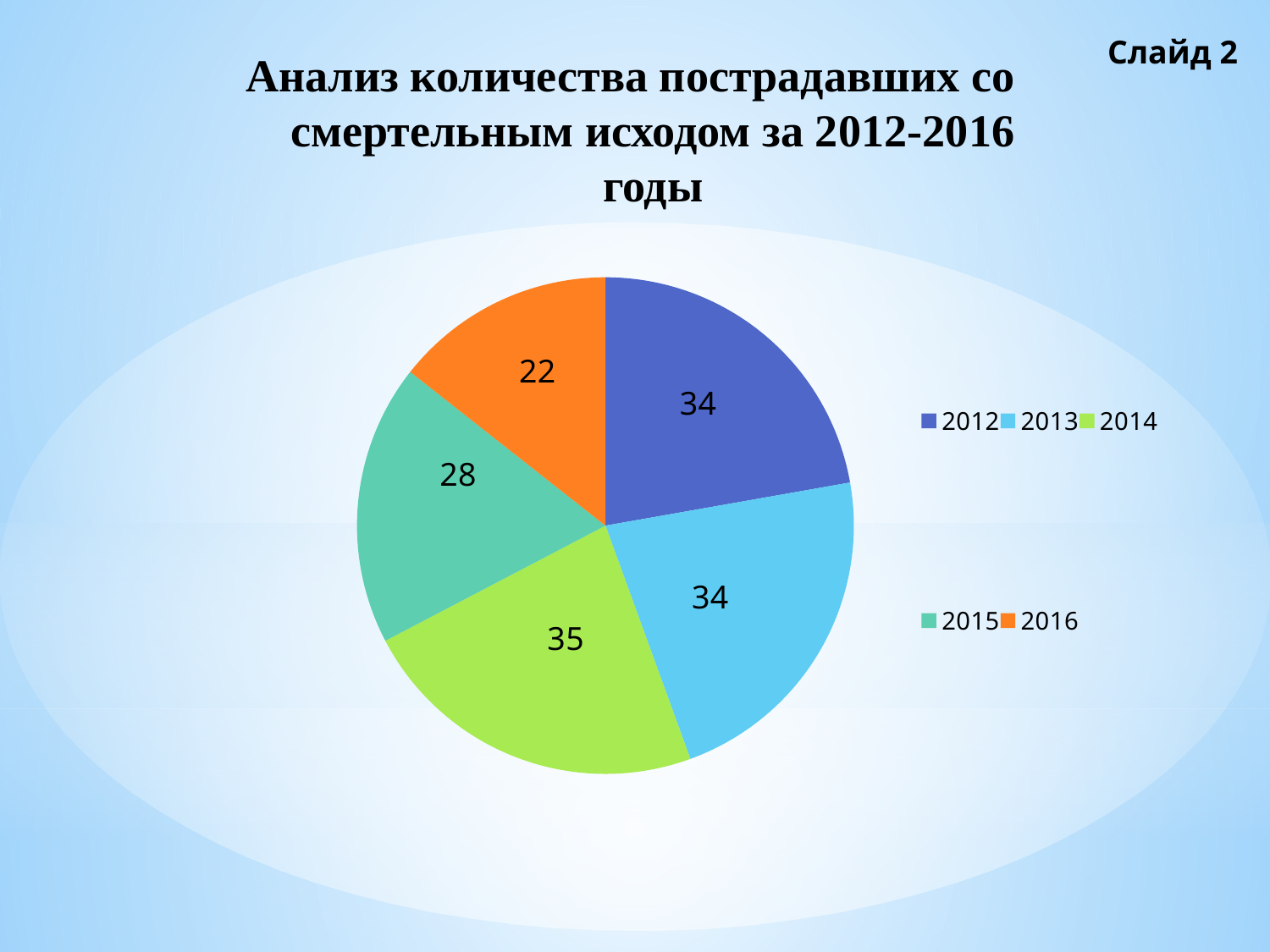
What is the value for 2016? 22 What is the value for 2015? 28 What is the difference between the values for 2015 and 2016? 6 How many slices does the pie chart have? 5 What is the value for 2014? 35 Which year has the lowest value? 2016 Which year has the highest value? 2014 What is the value for 2012? 34 What type of chart is shown on the slide? pie chart Which is larger, the value for 2014 or the value for 2015? 2014 Which year is shown in orange in the legend? 2016 What is the total of all slices in the pie chart? 153